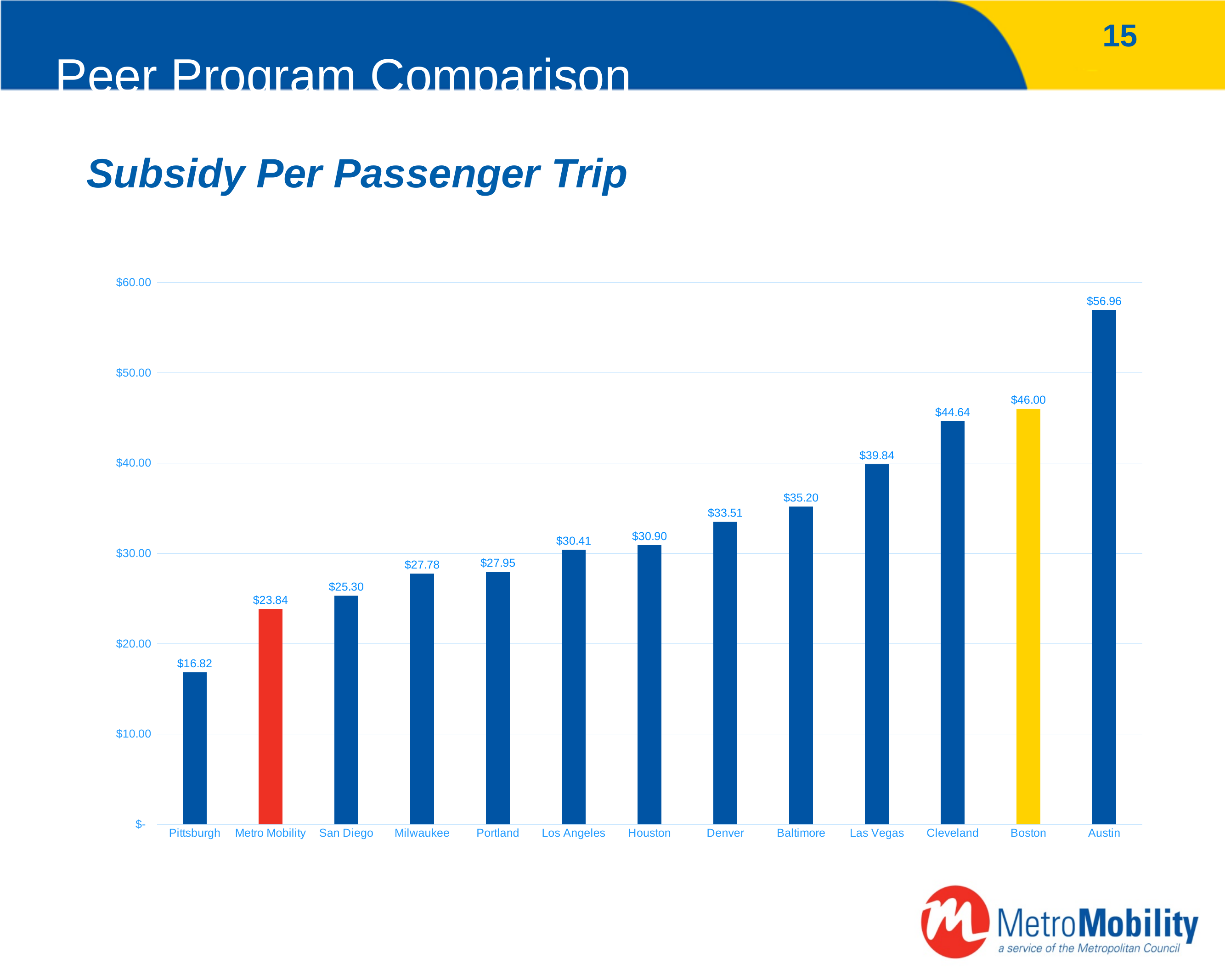
Which bar in the chart is coloured red? Metro Mobility Is the subsidy per passenger trip for Baltimore greater or less than $30.00? greater What is the difference between the subsidy per passenger trip for Austin and for Pittsburgh? $40.14 What is the difference between the subsidy per passenger trip for Boston and for Metro Mobility? $22.16 How many cities or programs are shown in the chart? 13 What is the subsidy per passenger trip for Boston? $46.00 What kind of chart is shown on the slide? Bar chart What is the subsidy per passenger trip for Metro Mobility? $23.84 What is the subsidy per passenger trip for Denver? $33.51 Which city has the lowest subsidy per passenger trip? Pittsburgh Which has a higher subsidy per passenger trip, Cleveland or Las Vegas? Cleveland Which city has the highest subsidy per passenger trip? Austin